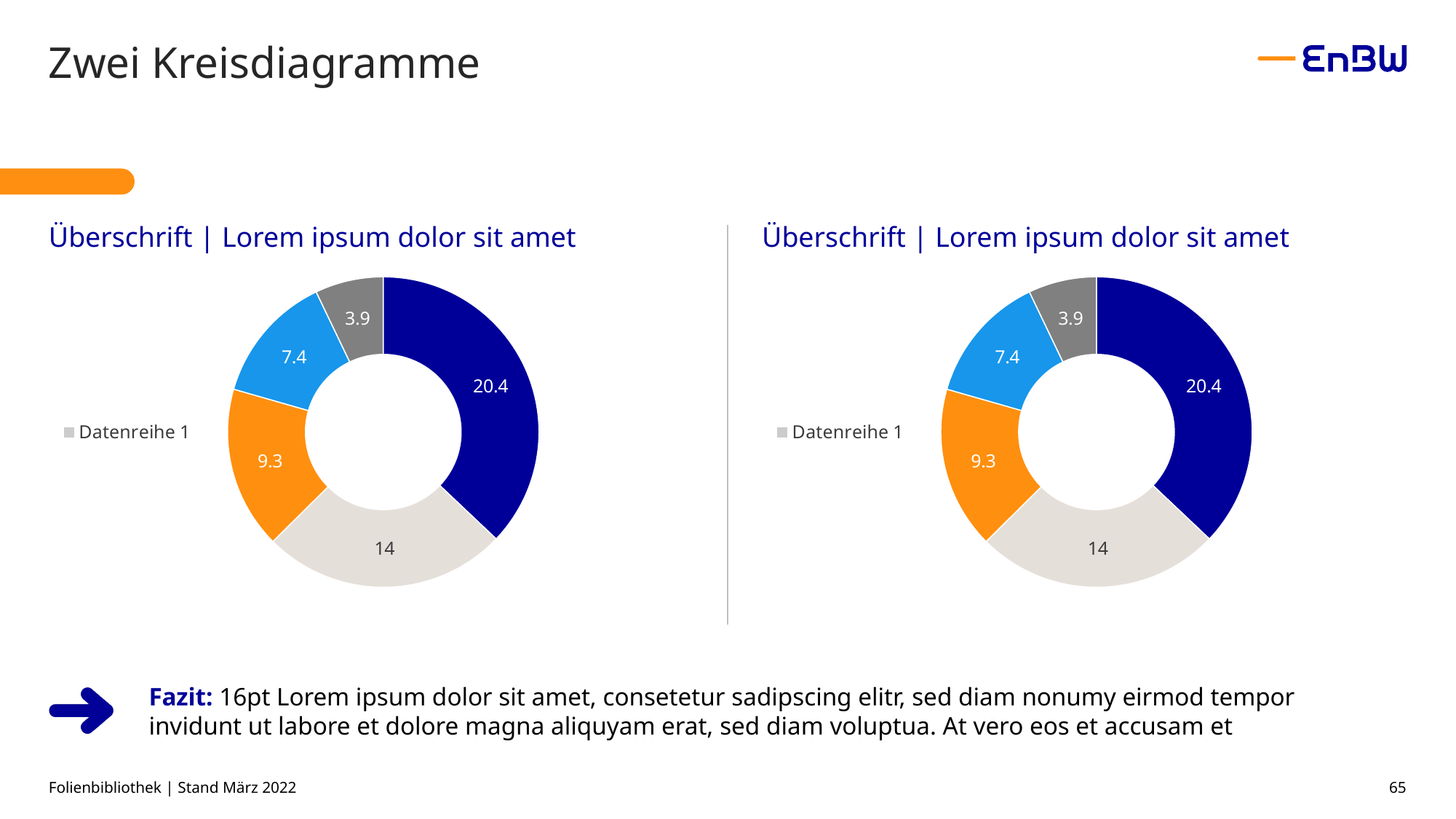
What kind of chart is the left chart on the slide? Doughnut (pie) chart In the left chart, what is the value of the light grey slice at the bottom? 14 In the right chart, what is the value of the orange slice? 9.3 How many slices does the left chart have? 5 How many series does the legend of the right chart list? 1 In the left chart, what is the value of the dark blue slice? 20.4 In the left chart, what is the largest slice value? 20.4 In the right chart, which slice is larger: the orange slice or the light blue slice? The orange slice (9.3) In the right chart, what is the smallest slice value? 3.9 What is the legend entry shown next to the left chart? Datenreihe 1 In the right chart, what is the value of the light blue slice? 7.4 In the left chart, what is the difference between the largest slice (20.4) and the light grey slice (14)? 6.4